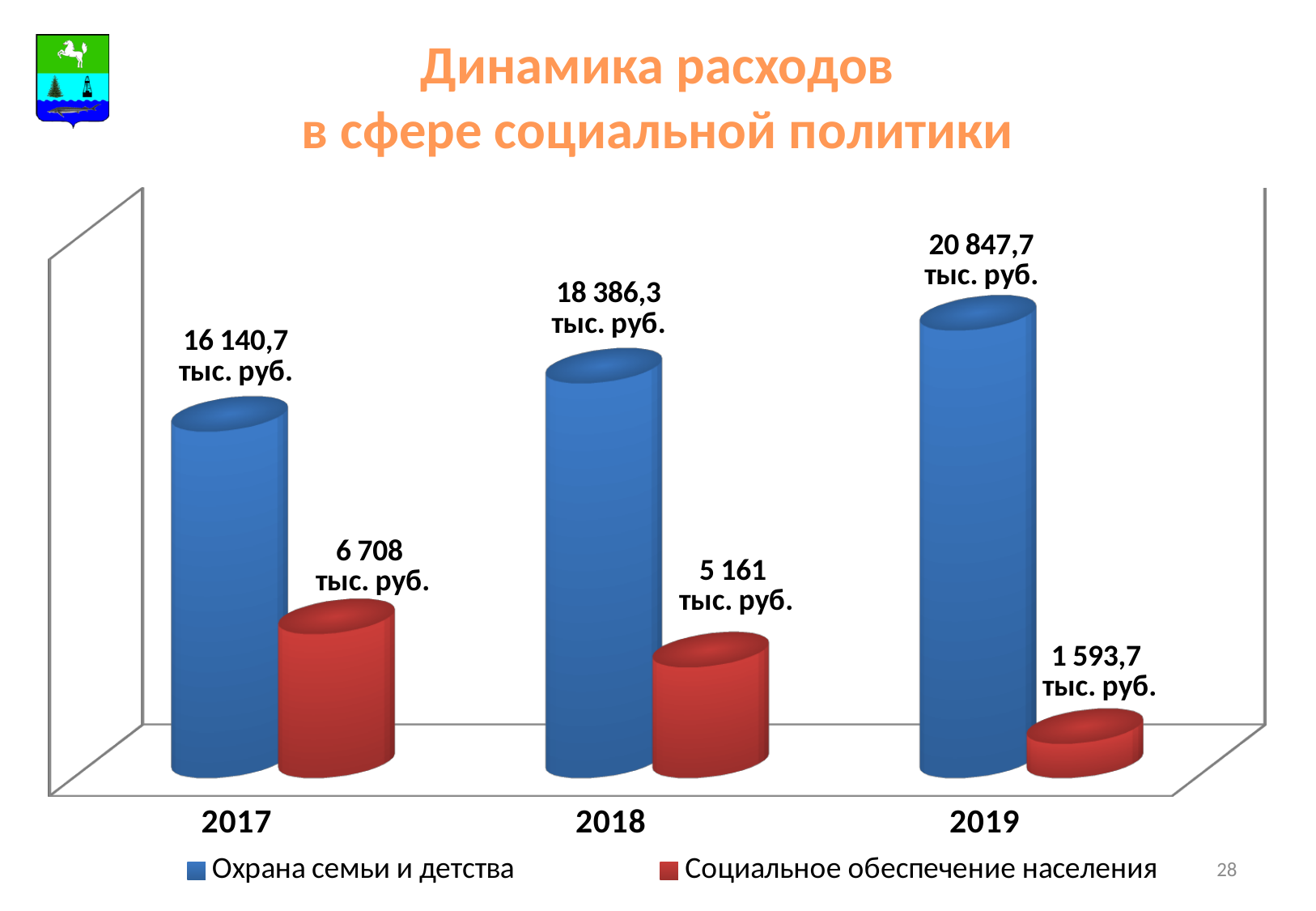
What kind of chart is shown on the slide? Bar chart How many years are shown on the x axis? 3 Do the values for Социальное обеспечение населения rise or fall from 2017 to 2019? Fall What is the difference between Социальное обеспечение населения in 2017 and in 2019? 5 114,3 тыс. руб. How many series does the legend list? 2 What is the value for Социальное обеспечение населения in 2019? 1 593,7 тыс. руб. In which year is Социальное обеспечение населения lowest? 2019 In which year is Охрана семьи и детства highest? 2019 What is the difference between Охрана семьи и детства in 2019 and in 2017? 4 707 тыс. руб. What is the value for Социальное обеспечение населения in 2018? 5 161 тыс. руб. Which is larger in 2018: Охрана семьи и детства or Социальное обеспечение населения? Охрана семьи и детства What is the value for Охрана семьи и детства in 2017? 16 140,7 тыс. руб.